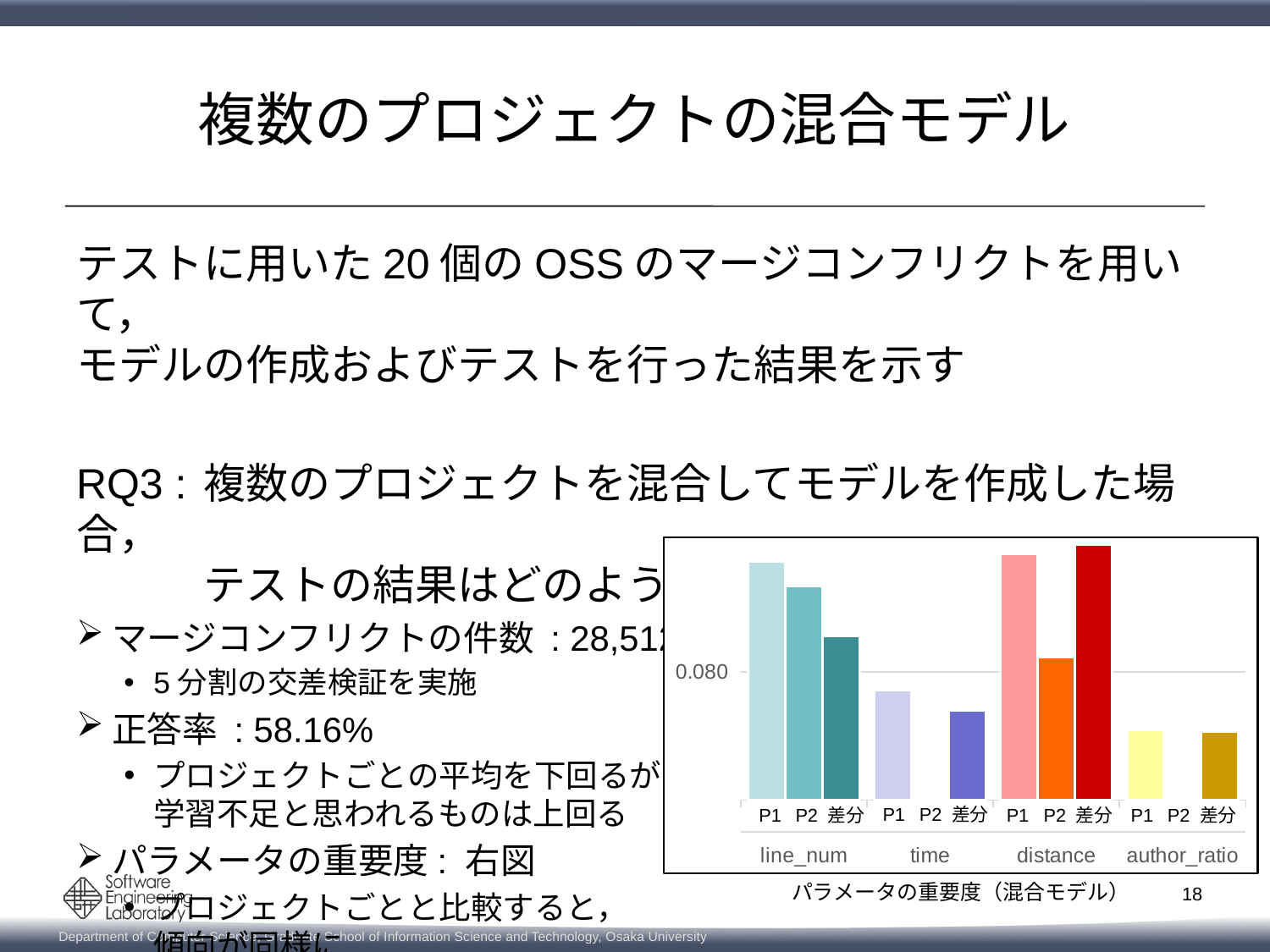
Which parameter groups are labelled on the x axis of the chart? line_num, time, distance, author_ratio Is the value for 差分 in the line_num group greater or less than 0.080? greater What is the caption of the chart on the slide? パラメータの重要度（混合モデル） Which is larger, P1 in the time group or P1 in the author_ratio group? P1 in the time group Is the value for P1 in the time group greater or less than 0.080? less In the line_num group, which is larger, P1 or 差分? P1 In the distance group, which is larger, P2 or 差分? 差分 Is the value for P1 in the author_ratio group greater or less than 0.080? less What kind of chart is shown on the slide? bar chart How many parameter groups are shown along the x axis of the chart? 4